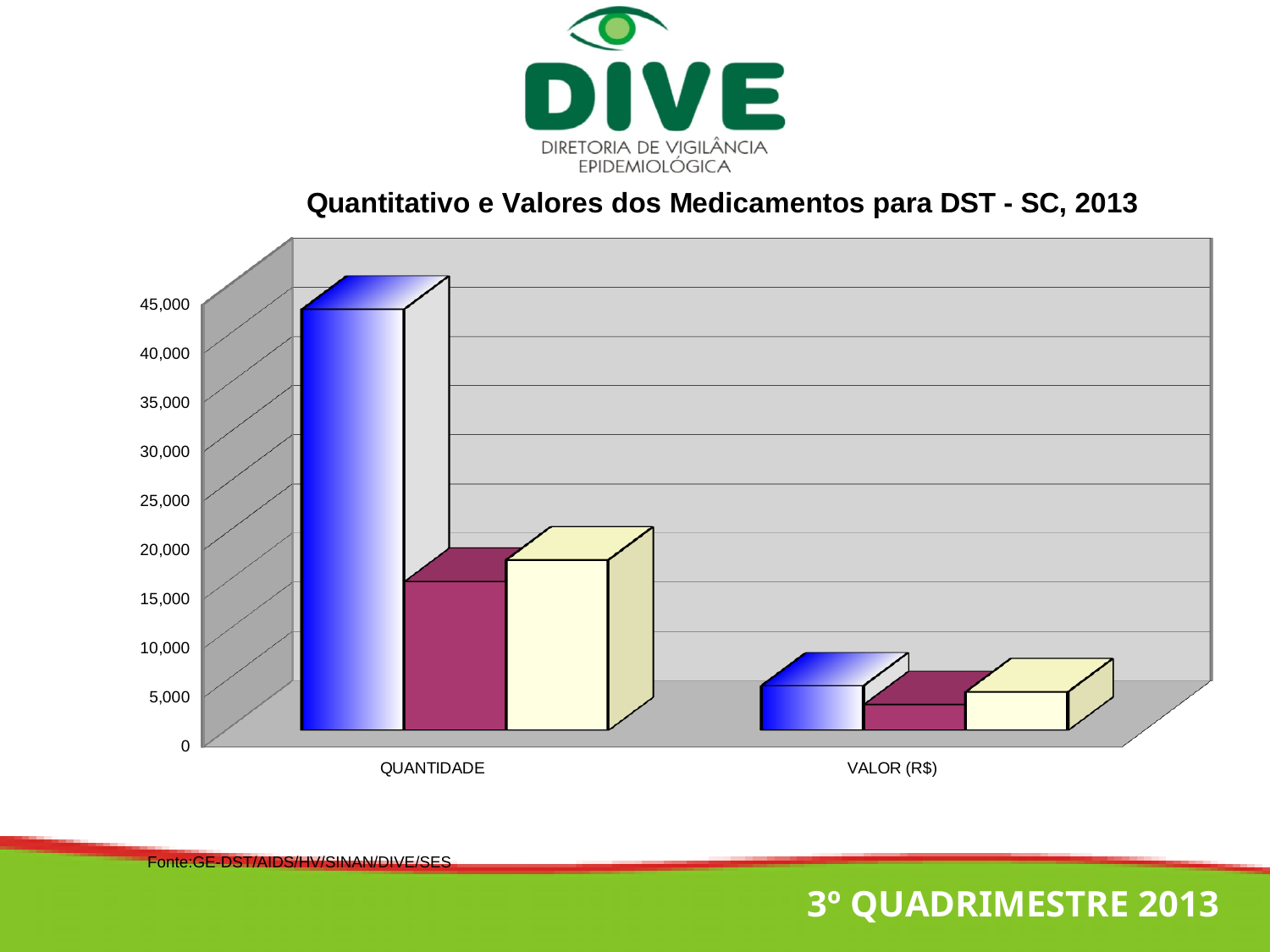
Which bar is taller in the QUANTIDADE category, the blue bar or the yellow bar? the blue bar Is the value of the magenta bar for QUANTIDADE greater or less than 20,000? less Is the value of the yellow bar for QUANTIDADE greater or less than 20,000? less Which category has the tallest bar overall, QUANTIDADE or VALOR (R$)? QUANTIDADE Is the value of the blue bar for QUANTIDADE greater or less than 40,000? greater What is the highest value shown on the vertical axis? 45,000 How many categories are shown on the x axis? 2 How many bars are plotted for the QUANTIDADE category? 3 What kind of chart is shown on the slide? bar chart What is the title of the chart? Quantitativo e Valores dos Medicamentos para DST - SC, 2013